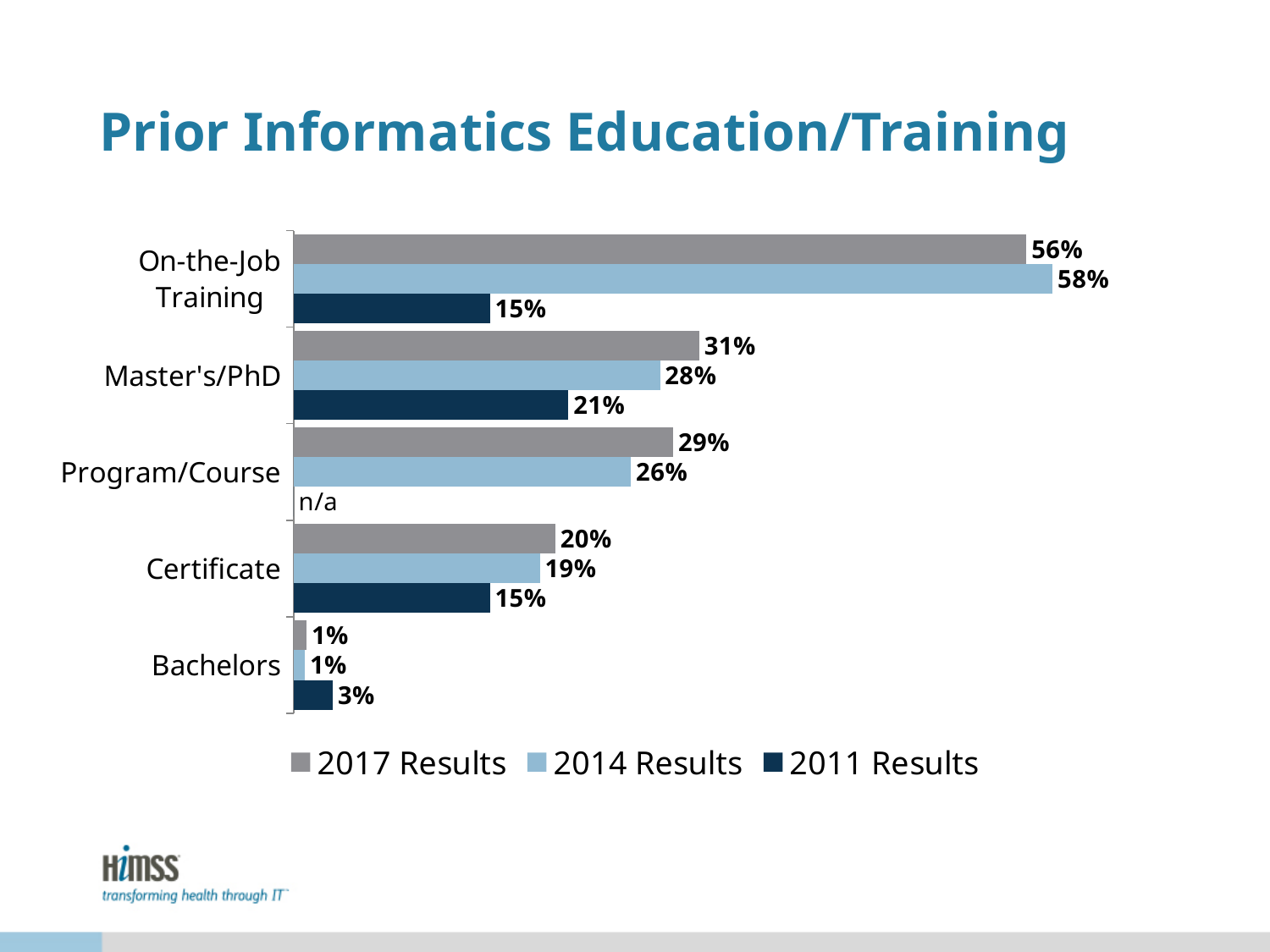
How many categories are shown on the chart? 5 What is the 2017 Results value for On-the-Job Training? 56% What is the difference between the 2014 Results and 2011 Results values for On-the-Job Training? 43% How many series does the legend list? 3 What is the 2011 Results value for Master's/PhD? 21% Which is larger for Master's/PhD: the 2017 Results value or the 2014 Results value? 2017 Results What is shown for the 2011 Results value for Program/Course? n/a Which category has the lowest 2017 Results value? Bachelors What is the title of the chart? Prior Informatics Education/Training Which category has the highest 2014 Results value? On-the-Job Training What is the 2014 Results value for Certificate? 19% What kind of chart is shown on the slide? Bar chart